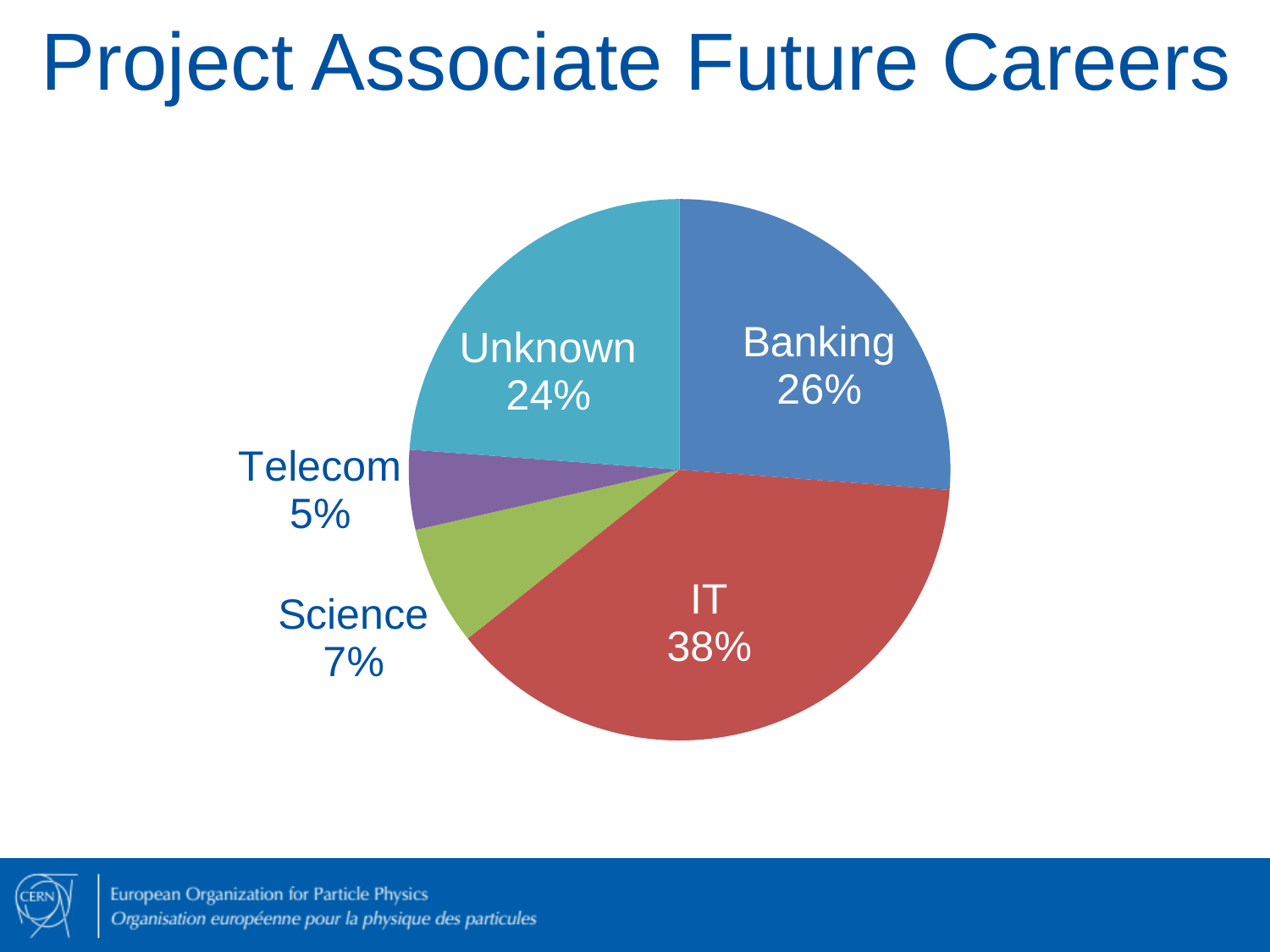
How many categories are shown in the pie chart? 5 What is the value shown for Science? 7% What is the title of the slide containing the chart? Project Associate Future Careers What is the value shown for Unknown? 24% What share of the pie does IT represent? 38% Which category has the smallest slice of the pie? Telecom Which is larger, Banking or Unknown? Banking What is the value shown for Telecom? 5% Which category has the largest slice of the pie? IT What kind of chart is shown on the slide? pie chart What is the difference in percentage points between IT and Banking? 12 What is the value shown for Banking? 26%